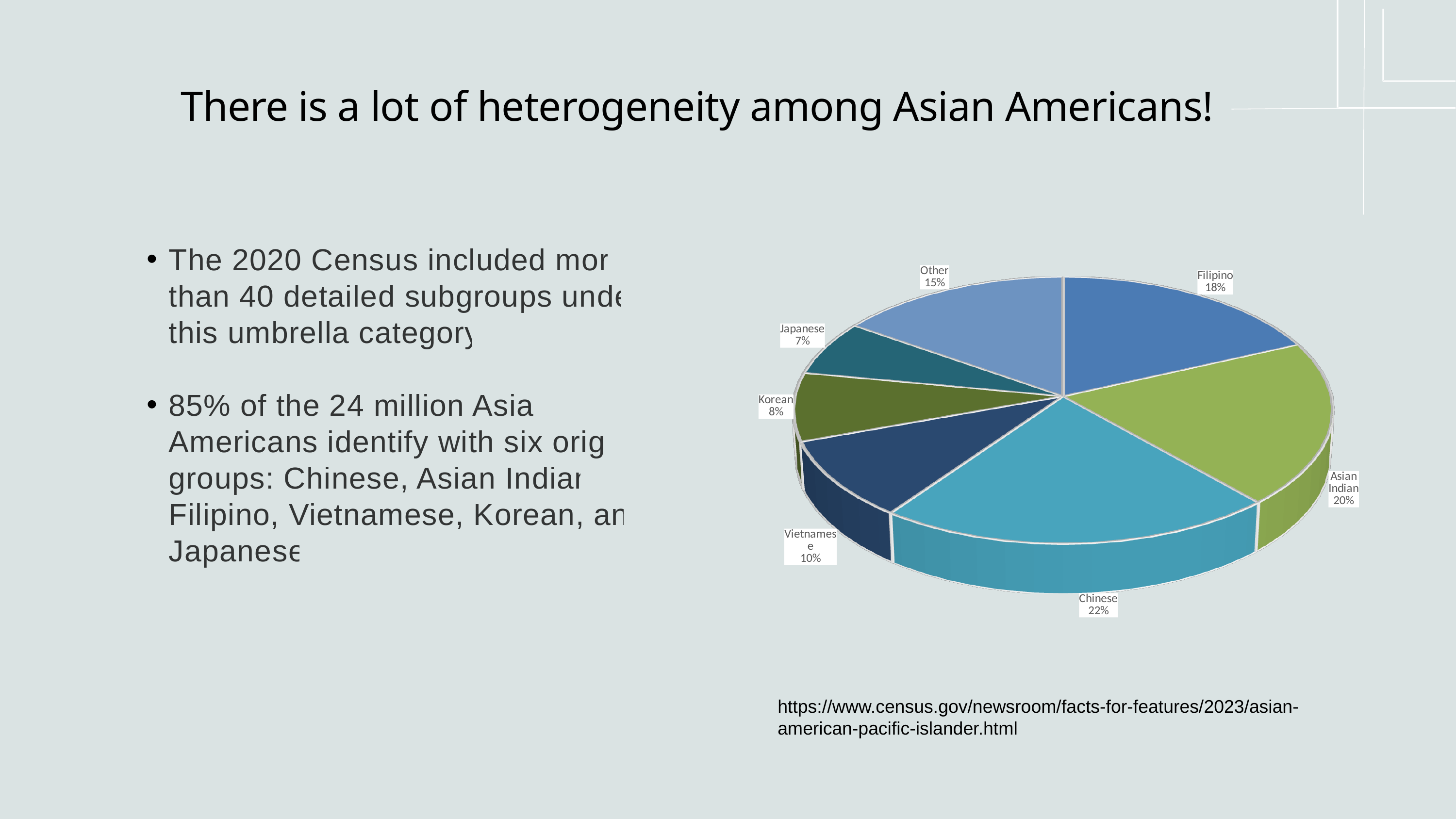
What is the value shown for Filipino? 18% Which group has the smallest slice of the pie? Japanese Which group has the largest slice of the pie? Chinese What is the value shown for Vietnamese? 10% What is the value shown for Korean? 8% How many slices does the pie chart have? 7 What is the value shown for Asian Indian? 20% What kind of chart is shown on the slide? pie chart What is the difference between the Chinese and Japanese shares? 15% What share of the pie does Chinese represent? 22% What is the value shown for Other? 15% Which is larger, the share for Filipino or the share for Other? Filipino